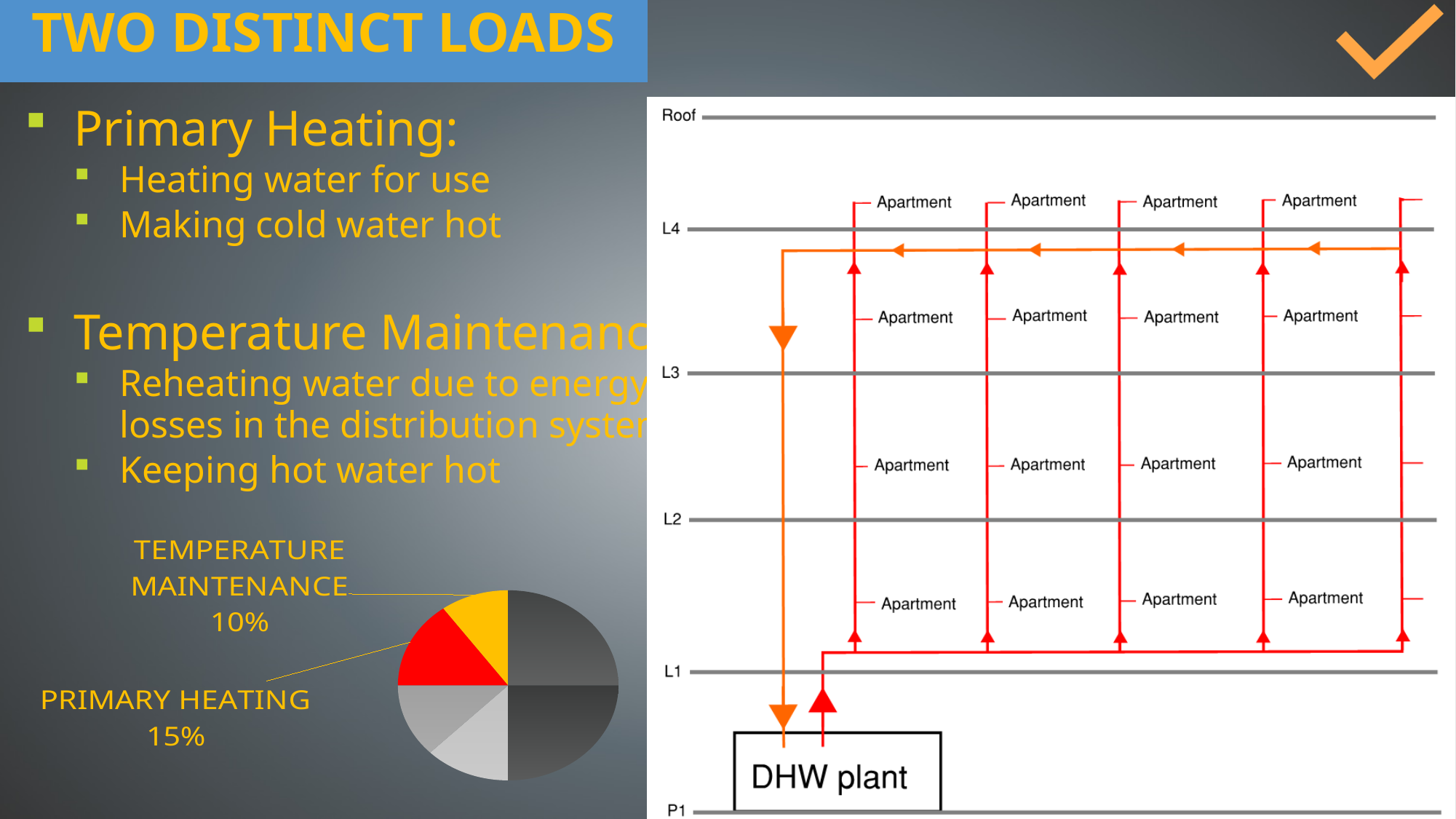
In the pie chart, what colour is the Primary Heating slice? red In the pie chart, what share of the pie does Temperature Maintenance represent? 10% In the pie chart, what percentage is shown for Temperature Maintenance? 10% In the pie chart, what percentage is shown for Primary Heating? 15% How many slices of the pie chart have a text label with a percentage? 2 What kind of chart is shown at the bottom left of the slide? pie chart In the pie chart, what share of the pie does Primary Heating represent? 15% In the pie chart, what is the difference between the Primary Heating and Temperature Maintenance percentages? 5% In the pie chart, what colour is the Temperature Maintenance slice? yellow In the pie chart, which is larger: Primary Heating or Temperature Maintenance? Primary Heating